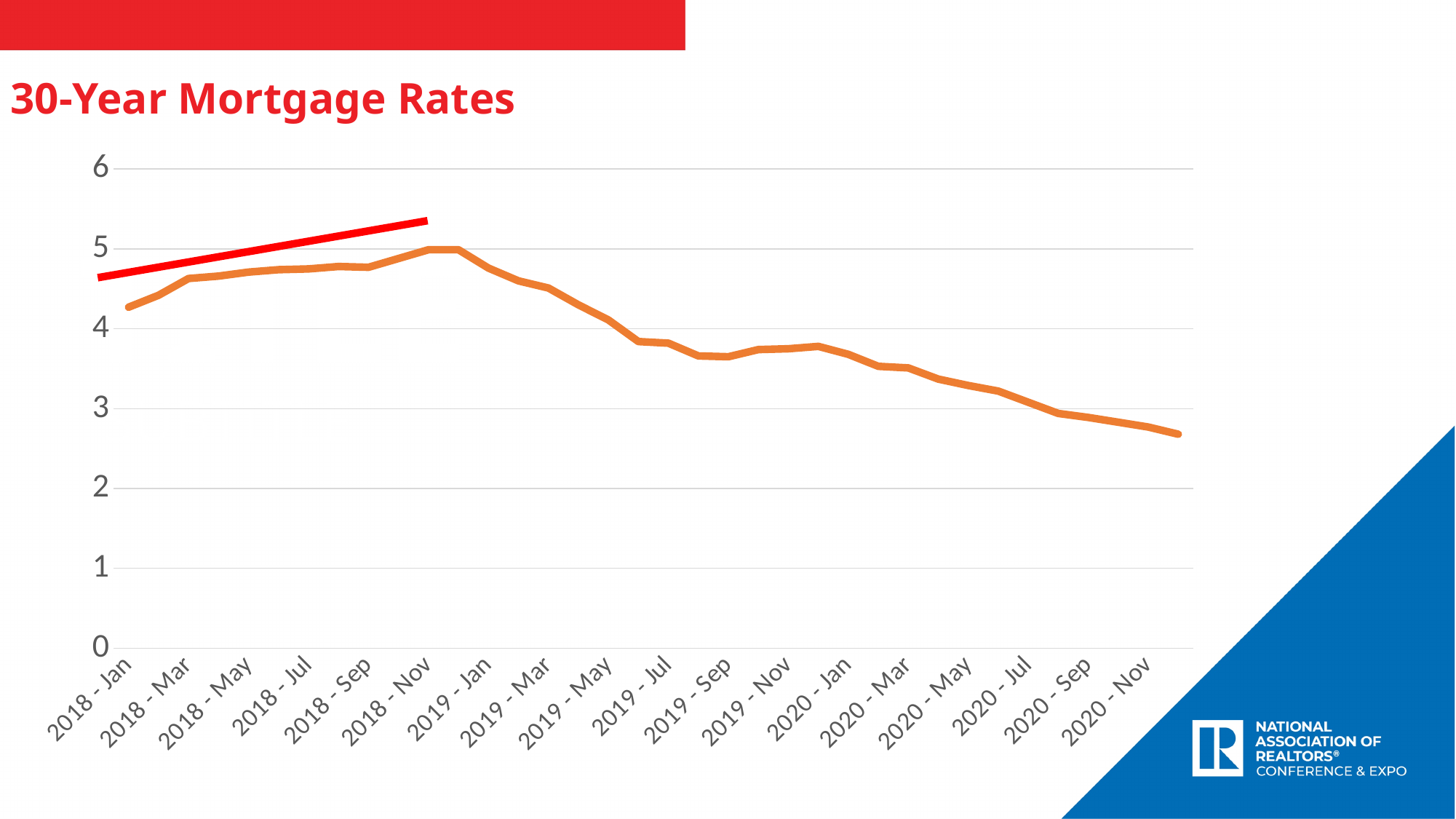
Do the values rise or fall from 2018 - Jan to 2018 - Nov? rise Do the values rise or fall from 2019 - Jan to 2020 - Nov? fall What kind of chart is shown on the slide? line chart Is the value for 2020 - Jan greater or less than 4? less Is the value for 2019 - Sep greater or less than 4? less Which is larger, the value for 2018 - Jan or the value for 2020 - Nov? 2018 - Jan Is the value for 2020 - Nov greater or less than 3? less Which labeled month has the lowest mortgage rate? 2020 - Nov What is the title of the chart? 30-Year Mortgage Rates Which is larger, the value for 2018 - Sep or the value for 2019 - Sep? 2018 - Sep